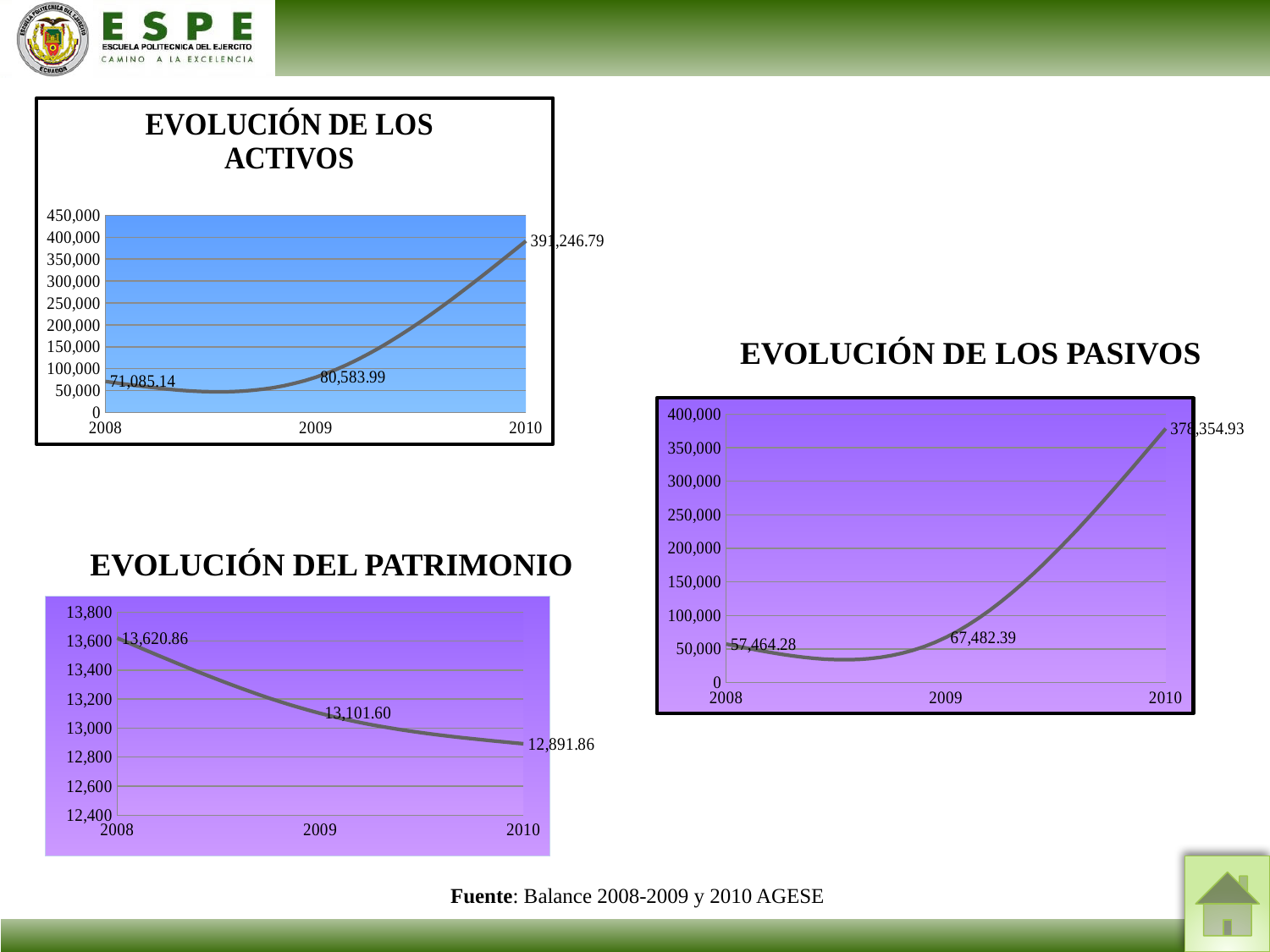
In the 'EVOLUCIÓN DEL PATRIMONIO' chart, what is the difference between the 2008 and 2010 values? 729.00 What kind of chart is 'EVOLUCIÓN DE LOS PASIVOS'? line chart In the 'EVOLUCIÓN DE LOS PASIVOS' chart, which year has the highest value? 2010 In the 'EVOLUCIÓN DEL PATRIMONIO' chart, which year has the lowest value? 2010 In the 'EVOLUCIÓN DE LOS PASIVOS' chart, what is the difference between the 2009 and 2008 values? 10,018.11 In the 'EVOLUCIÓN DE LOS ACTIVOS' chart, what is the value for 2010? 391,246.79 In the 'EVOLUCIÓN DE LOS PASIVOS' chart, what is the value for 2009? 67,482.39 In the 'EVOLUCIÓN DEL PATRIMONIO' chart, do the values rise or fall from 2008 to 2010? fall In the 'EVOLUCIÓN DEL PATRIMONIO' chart, what is the value for 2009? 13,101.60 In the 'EVOLUCIÓN DE LOS ACTIVOS' chart, what is the difference between the 2010 and 2009 values? 310,662.80 In the 'EVOLUCIÓN DE LOS ACTIVOS' chart, what is the value for 2008? 71,085.14 How many years are plotted in the 'EVOLUCIÓN DE LOS ACTIVOS' chart? 3